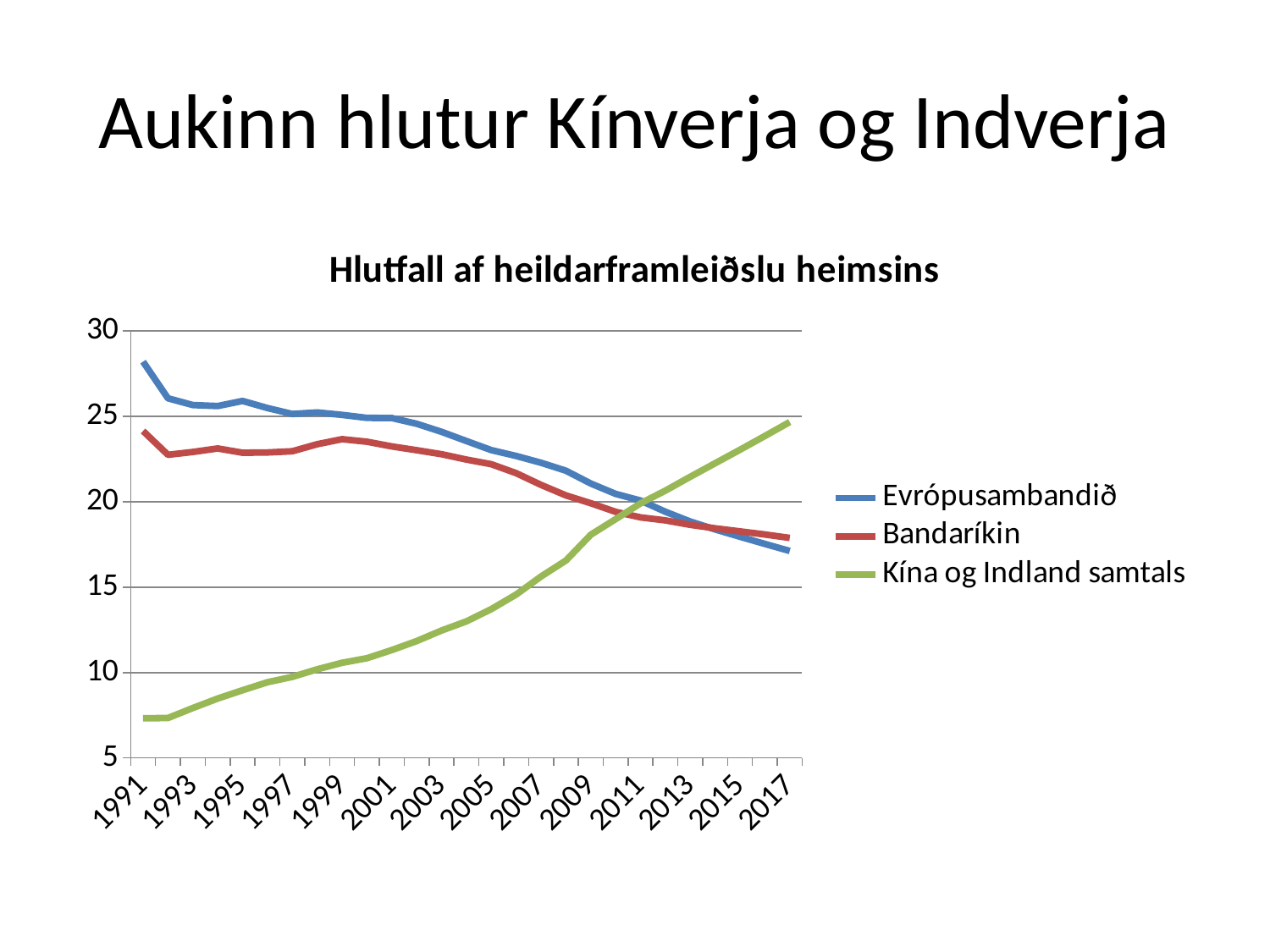
Which series has the highest value in 2017? Kína og Indland samtals How many series does the legend list? 3 Which series is drawn in green? Kína og Indland samtals What is the title of the chart? Hlutfall af heildarframleiðslu heimsins Is the value for Kína og Indland samtals in 1991 greater or less than 10? less Does the value for Kína og Indland samtals rise or fall from 1991 to 2017? rise Does the value for Evrópusambandið rise or fall from 1991 to 2017? fall What kind of chart is shown on the slide? line chart Is the value for Bandaríkin in 2017 greater or less than 20? less Is the value for Evrópusambandið in 1991 greater or less than 25? greater In 1991, which is larger: the value for Evrópusambandið or the value for Bandaríkin? Evrópusambandið